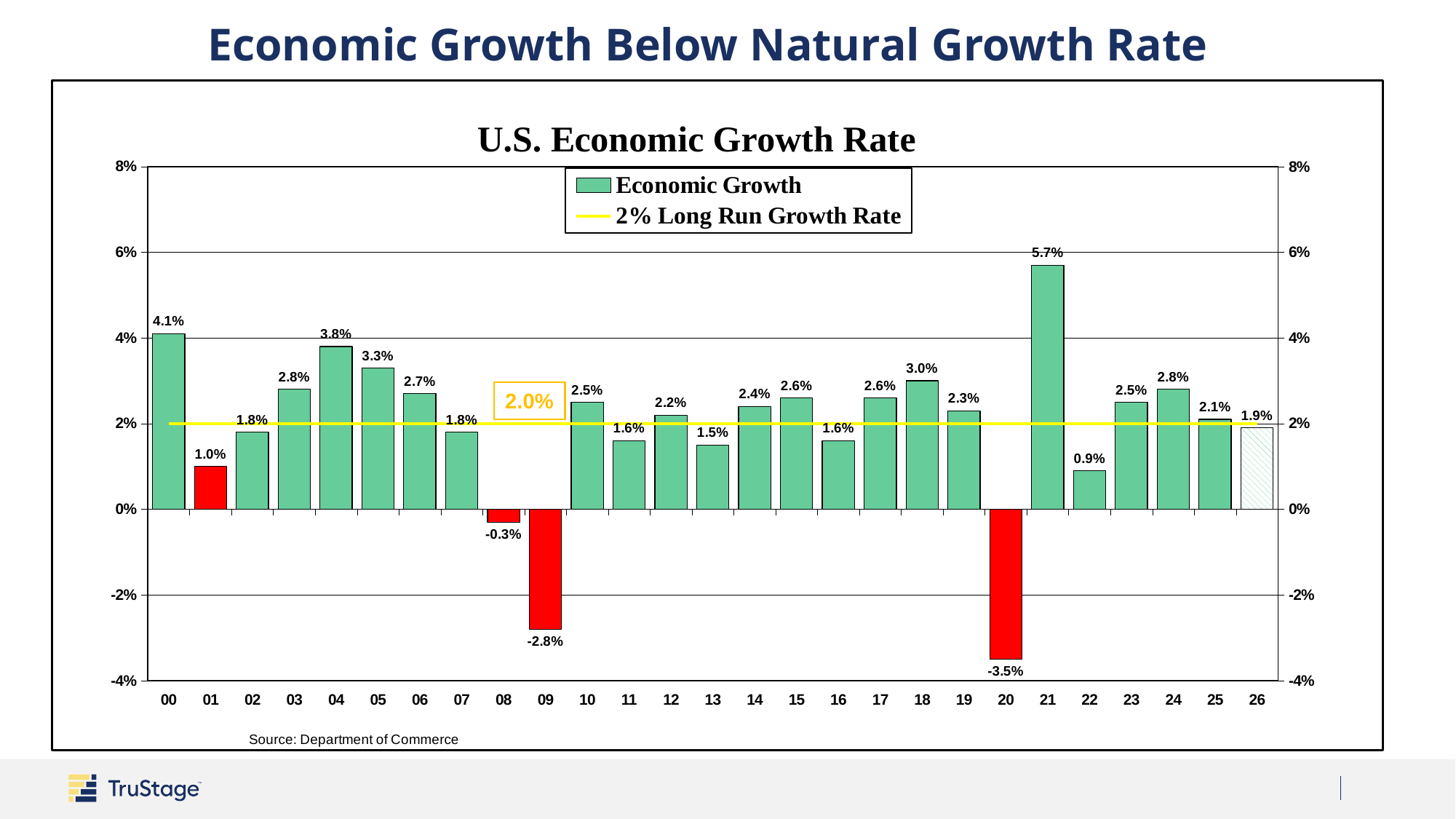
What is the difference between the growth rate in 00 and the growth rate in 01? 3.1% What is the economic growth rate shown for 21? 5.7% What is the economic growth rate shown for 09? -2.8% How many series does the legend list? 2 Which year has a higher growth rate, 04 or 05? 04 What kind of chart is this? bar chart Which year has the lowest economic growth rate? 20 Is the value for 18 greater or less than 2%? greater What is the economic growth rate shown for 26? 1.9% Which year has the highest economic growth rate? 21 What is the title of the chart? U.S. Economic Growth Rate How many years are shown on the x axis? 27